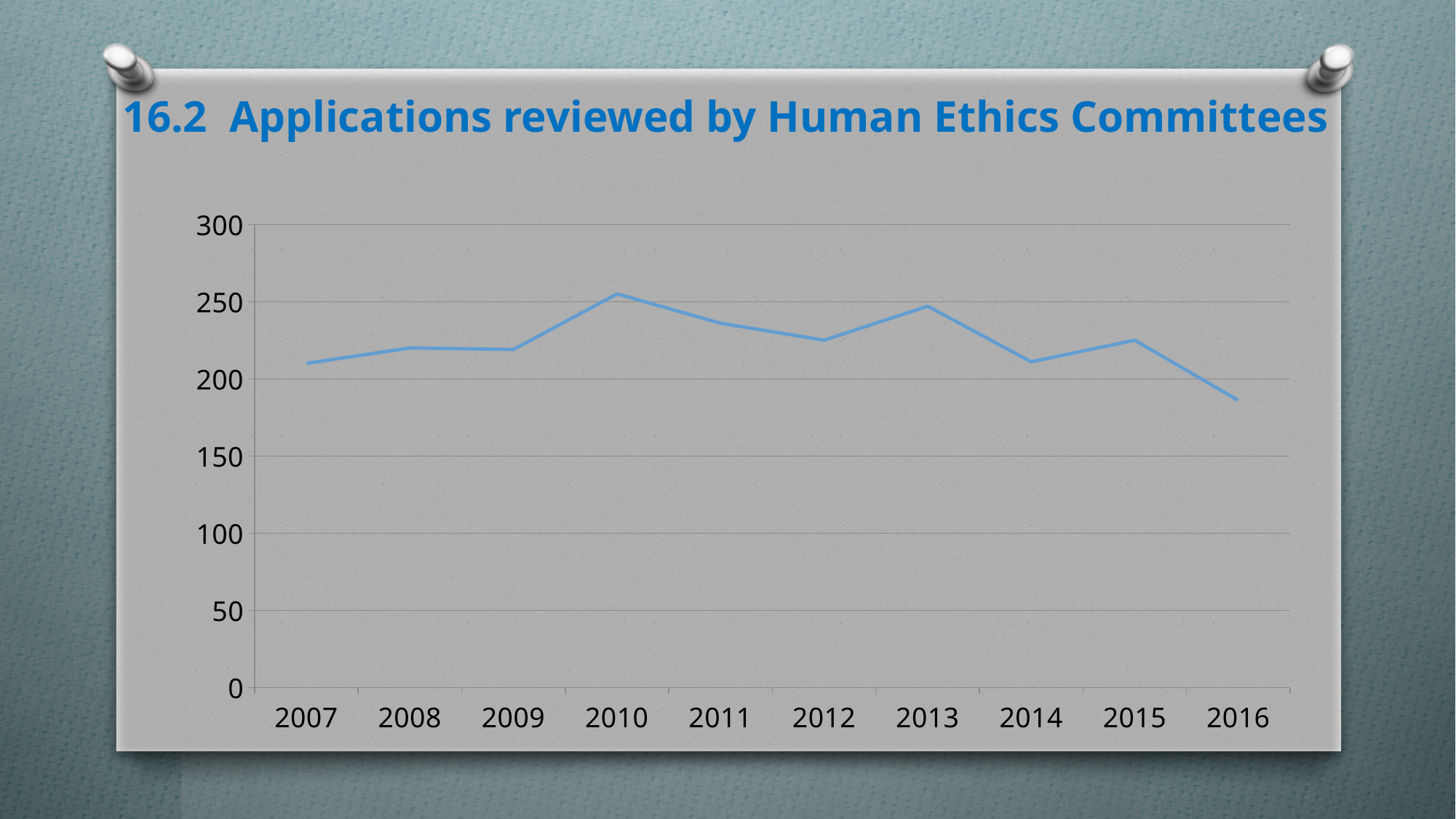
Does the line rise or fall between 2015 and 2016? fall Is the value for 2010 greater or less than 250? greater How many years are plotted on the x axis of the chart? 10 What kind of chart is shown on the slide? line chart Which year has the larger value, 2010 or 2016? 2010 In which year was the number of applications reviewed lowest? 2016 What is the title of the slide containing the chart? 16.2 Applications reviewed by Human Ethics Committees Is the value for 2007 greater or less than 200? greater In which year was the number of applications reviewed highest? 2010 Which year has the larger value, 2013 or 2014? 2013 Is the value for 2016 greater or less than 200? less